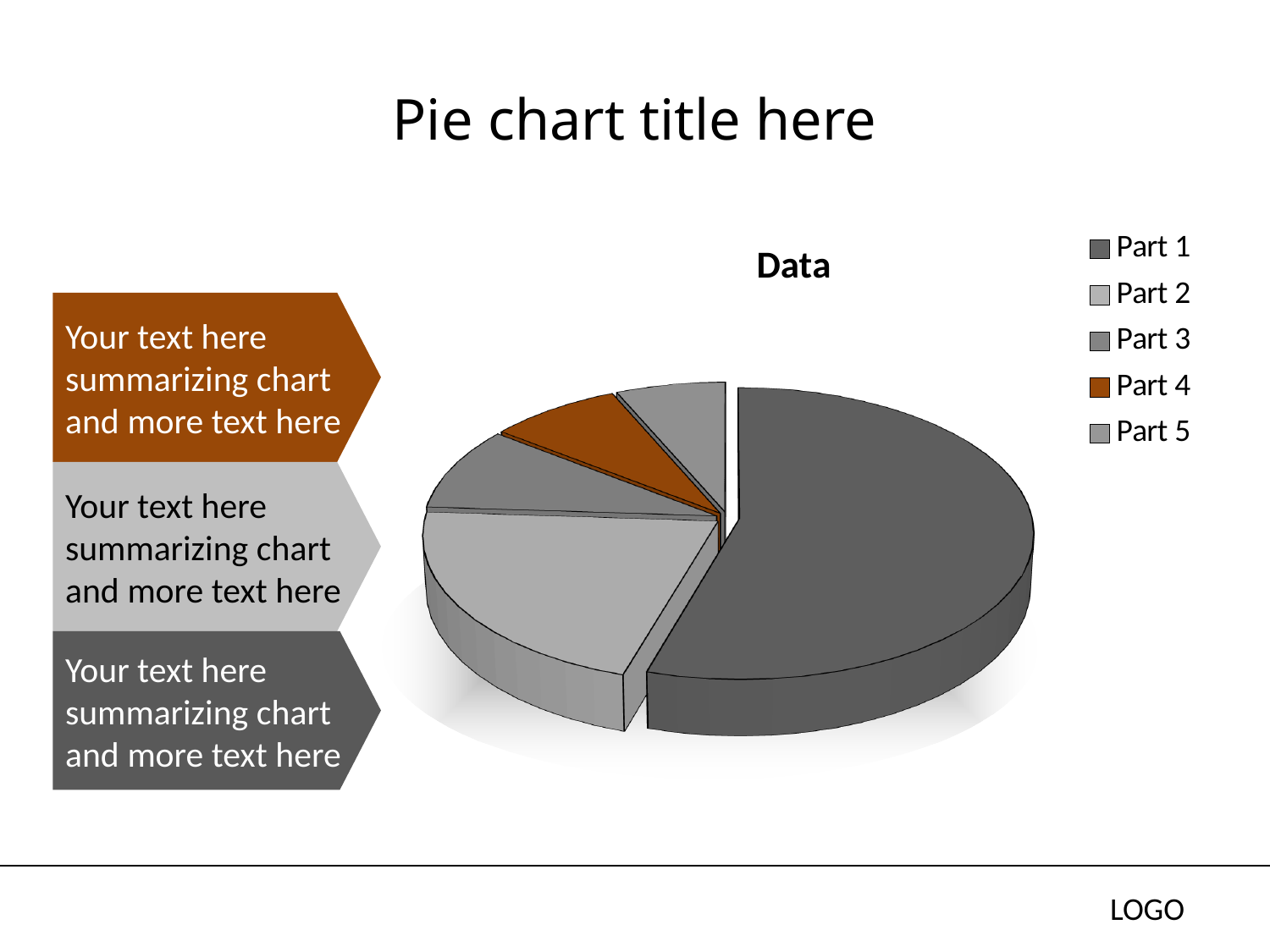
Which slice is larger, Part 1 or Part 4? Part 1 Which slice is larger, Part 1 or Part 2? Part 1 What is the title shown above the pie chart? Data Which slice is larger, Part 2 or Part 5? Part 2 What kind of chart is shown on the slide? pie chart How many entries does the legend of the pie chart list? 5 How many slices does the pie chart have? 5 Which part has the largest slice in the pie chart? Part 1 Which part is shown in orange in the pie chart? Part 4